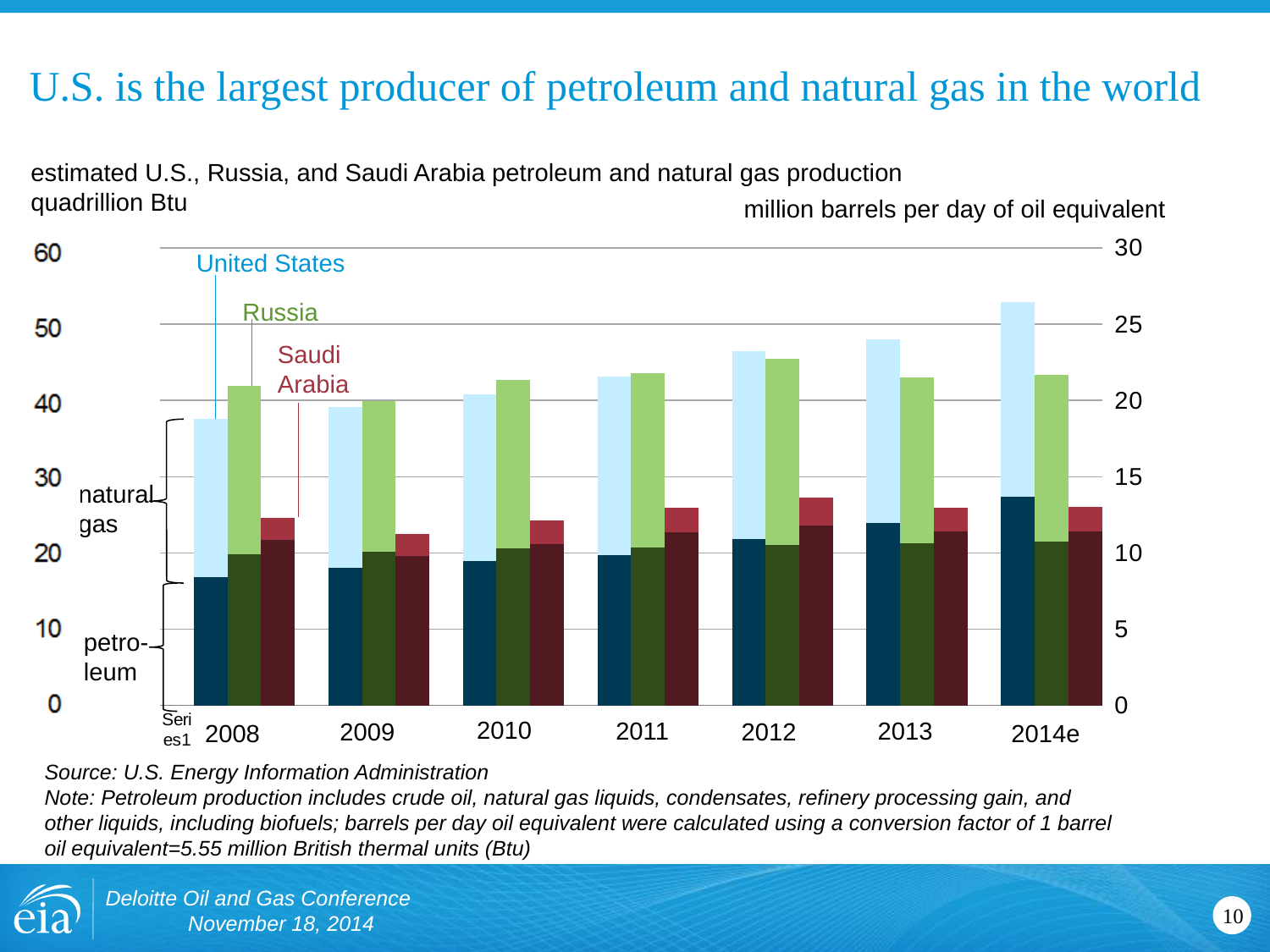
Is the total United States bar for 2014e greater or less than 50 quadrillion Btu? greater What kind of chart is shown on the slide? bar chart How many years are shown along the x axis of the chart? 7 Is the total Saudi Arabia bar for 2008 greater or less than 30 quadrillion Btu? less Do the total United States bars rise or fall from 2008 to 2014e? rise Is the total Russia bar for 2008 greater or less than 40 quadrillion Btu? greater What unit is shown on the left axis of the chart? quadrillion Btu What unit is shown on the right axis of the chart? million barrels per day of oil equivalent Which country has the tallest total bar in 2014e? United States In 2008, which total bar is taller, United States or Russia? Russia Which country has the shortest total bar in 2008? Saudi Arabia